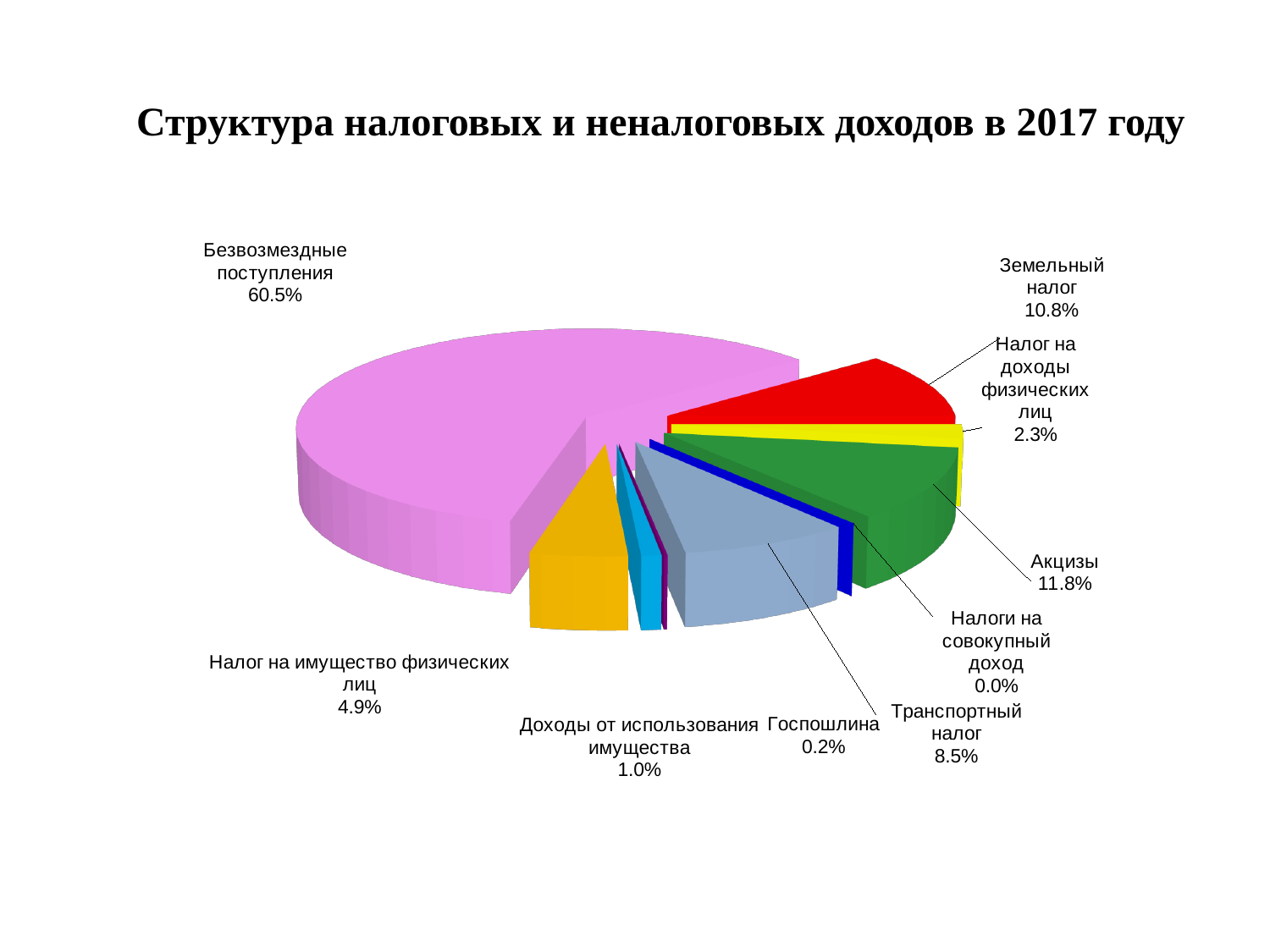
What is the difference between the shares of Акцизы and Земельный налог? 1.0% What is the title of the chart? Структура налоговых и неналоговых доходов в 2017 году Which is larger, the share of Транспортный налог or the share of Налог на доходы физических лиц? Транспортный налог What is the value shown for Акцизы? 11.8% Which category has the smallest share of the pie? Налоги на совокупный доход What is the value shown for Налог на имущество физических лиц? 4.9% How many categories are shown in the pie chart? 9 What is the value shown for Земельный налог? 10.8% What kind of chart is shown on the slide? Pie chart Which category has the largest share of the pie? Безвозмездные поступления What is the value shown for Транспортный налог? 8.5% What share of the pie is Безвозмездные поступления? 60.5%